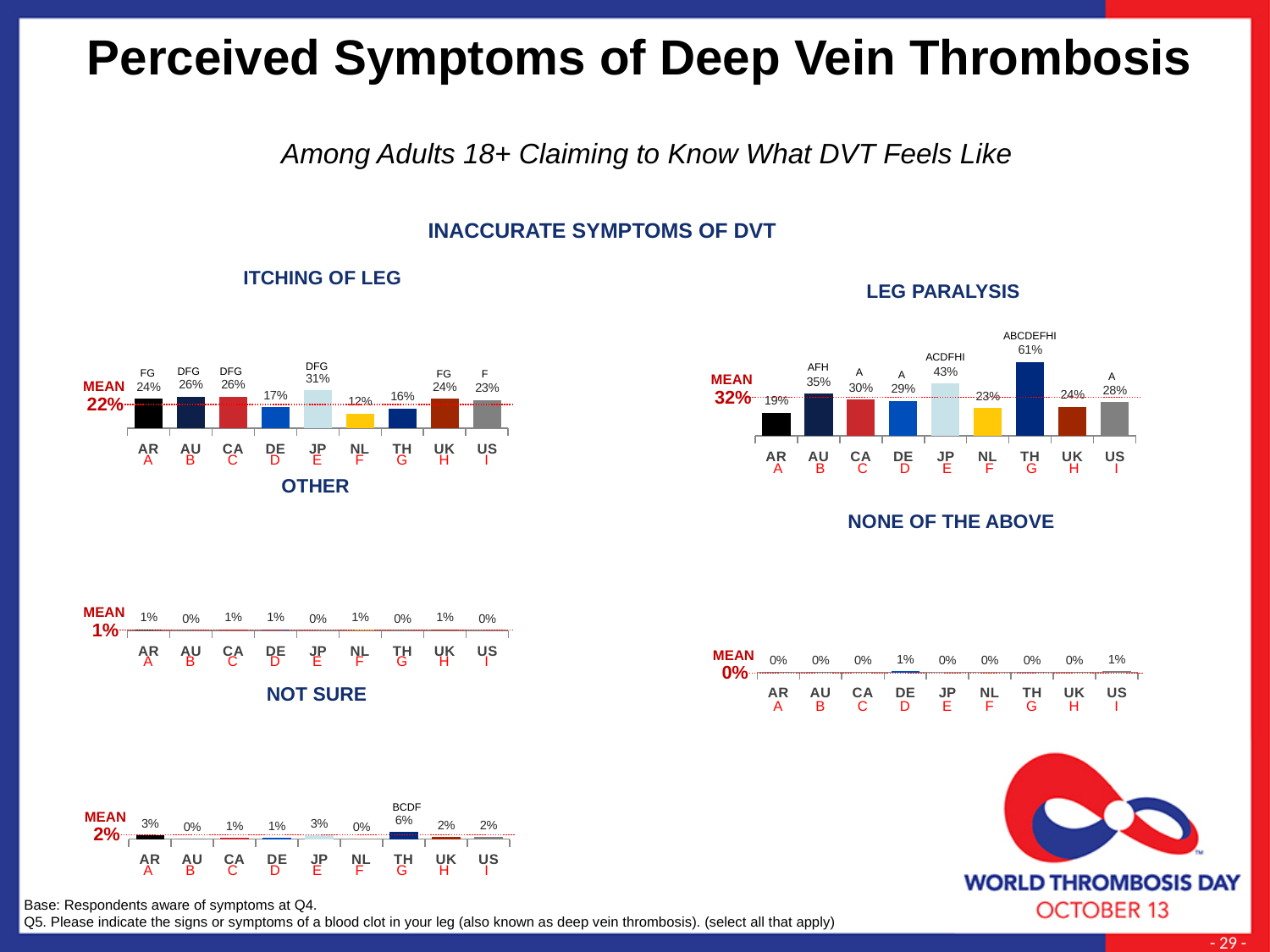
How many countries are shown in the Other chart? 9 In the Leg Paralysis chart, which is larger, the value for AU or the value for CA? AU In the Itching of Leg chart, what is the mean value shown? 22% In the Leg Paralysis chart, what is the difference between the values for TH and AR? 42% In the Not Sure chart, what is the value for TH? 6% In the Itching of Leg chart, which country has the lowest value? NL What type of chart is the Leg Paralysis chart? Bar chart In the Itching of Leg chart, what is the value for JP? 31% In the Leg Paralysis chart, what is the value for JP? 43% In the Not Sure chart, which country has the highest value? TH In the Leg Paralysis chart, which country has the highest value? TH In the None of the Above chart, what is the value for DE? 1%